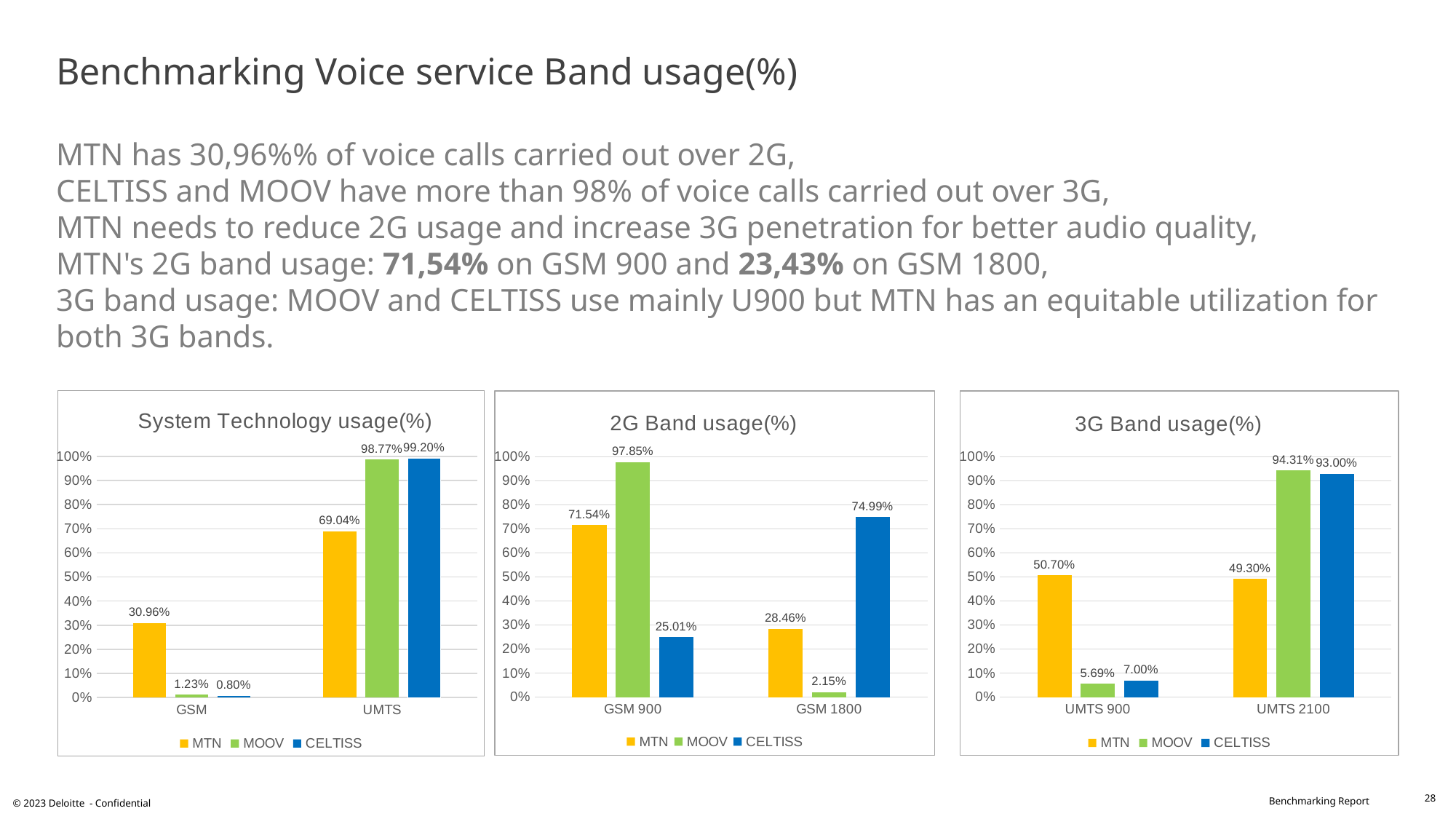
In the '2G Band usage(%)' chart, which is larger on GSM 900: MTN or CELTISS? MTN In the '2G Band usage(%)' chart, what is the value for MOOV on GSM 900? 97.85% In the '3G Band usage(%)' chart, what is the difference between MOOV's UMTS 2100 value and CELTISS's UMTS 2100 value? 1.31% In the '2G Band usage(%)' chart, what is the difference between CELTISS on GSM 1800 and CELTISS on GSM 900? 49.98% How many series does the legend of the '3G Band usage(%)' chart list? 3 In the '2G Band usage(%)' chart, which operator has the lowest value on GSM 1800? MOOV In the 'System Technology usage(%)' chart, what is the difference between MOOV's UMTS value and MOOV's GSM value? 97.54% What type of chart is the '2G Band usage(%)' chart? Bar chart In the 'System Technology usage(%)' chart, what is the value for MTN on GSM? 30.96% In the '3G Band usage(%)' chart, which operator has the highest value on UMTS 2100? MOOV In the '3G Band usage(%)' chart, what is the value for MTN on UMTS 900? 50.70% In the 'System Technology usage(%)' chart, which operator has the highest value on UMTS? CELTISS